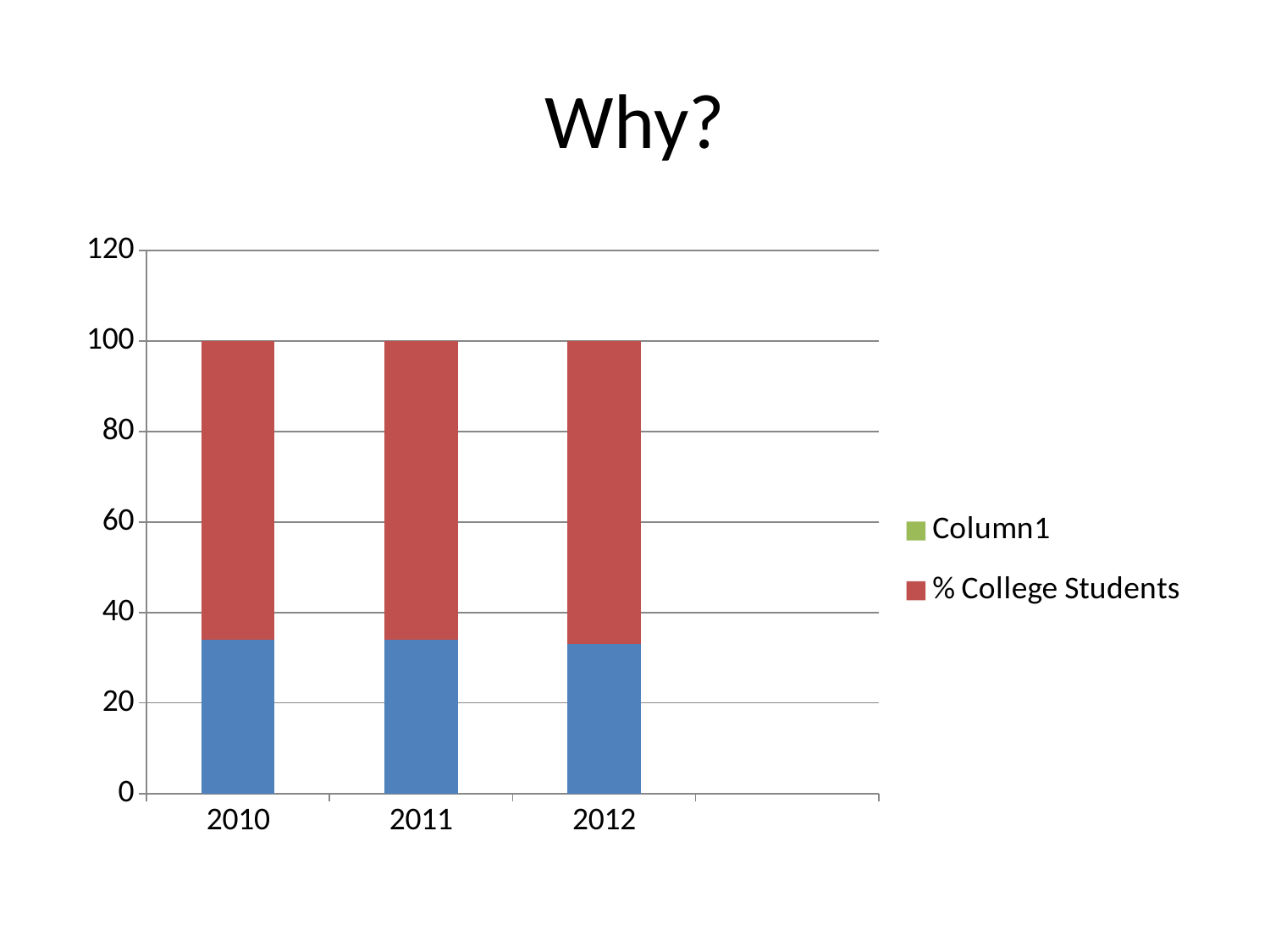
Is the value of the blue segment for 2012 greater or less than 40? less What is the title of the slide containing the chart? Why? Which legend entry is shown in red? % College Students What is the total height of the stacked bar for 2010? 100 What is the highest value shown on the vertical axis? 120 What is the total height of the stacked bar for 2012? 100 How many series does the chart's legend list? 2 Is the value of the blue segment for 2010 greater or less than 40? less Is the value of the blue segment for 2011 greater or less than 20? greater How many years are shown on the x axis of the chart? 3 What kind of chart is shown on the slide? bar chart